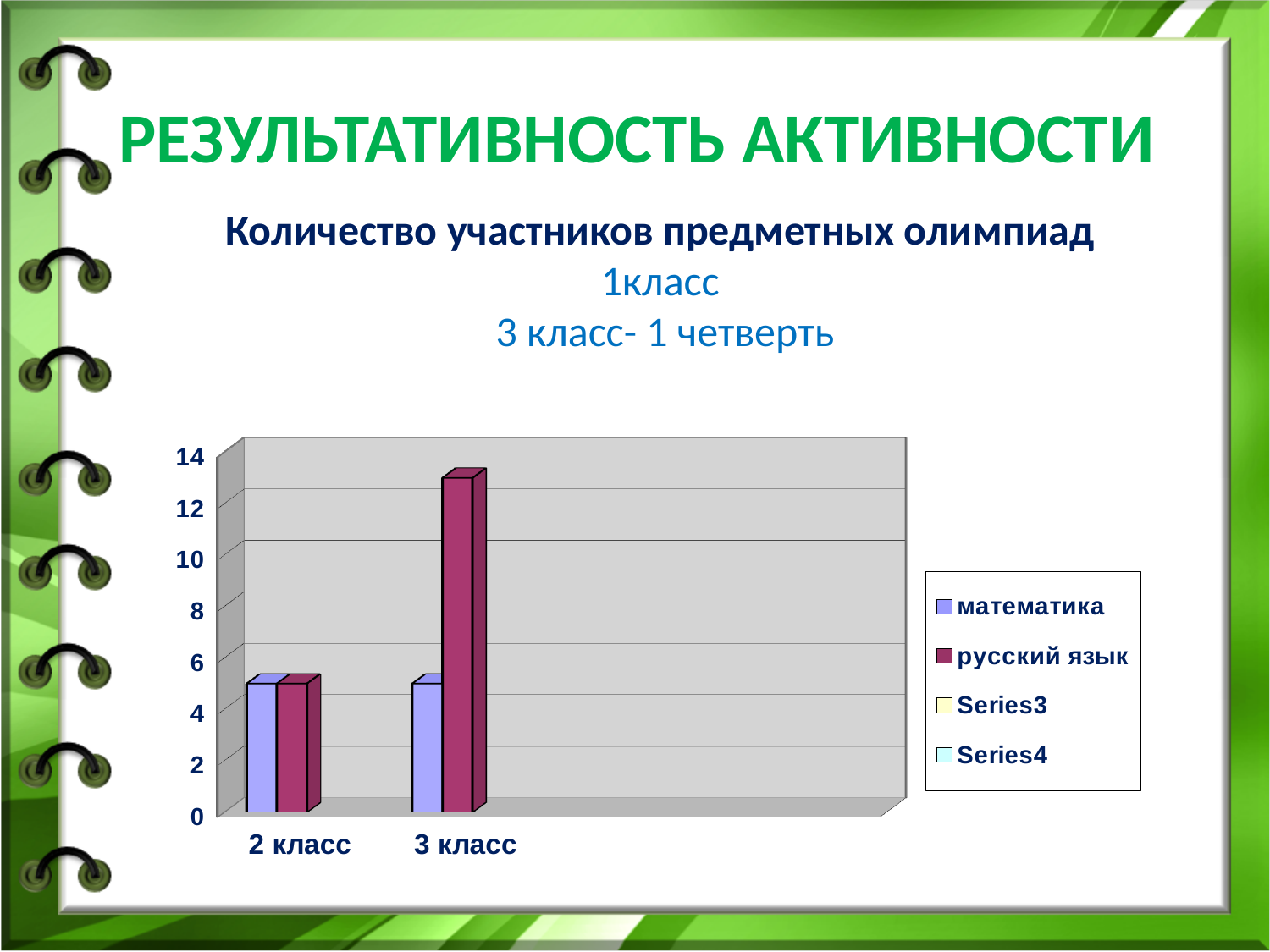
Does the value for русский язык rise or fall from 2 класс to 3 класс? rise Is the value for русский язык in 3 класс greater or less than 10? greater Is the value for математика in 3 класс greater or less than 4? greater How many categories are shown on the x axis of the chart? 2 In 3 класс, which is larger: the value for математика or the value for русский язык? русский язык What is the label of the second category on the x axis? 3 класс What kind of chart is shown on the slide? bar chart How many series does the chart's legend list? 4 Is the value for русский язык in 3 класс greater or less than 14? less What is the first series listed in the chart's legend? математика Which series and category has the tallest bar in the chart? русский язык, 3 класс